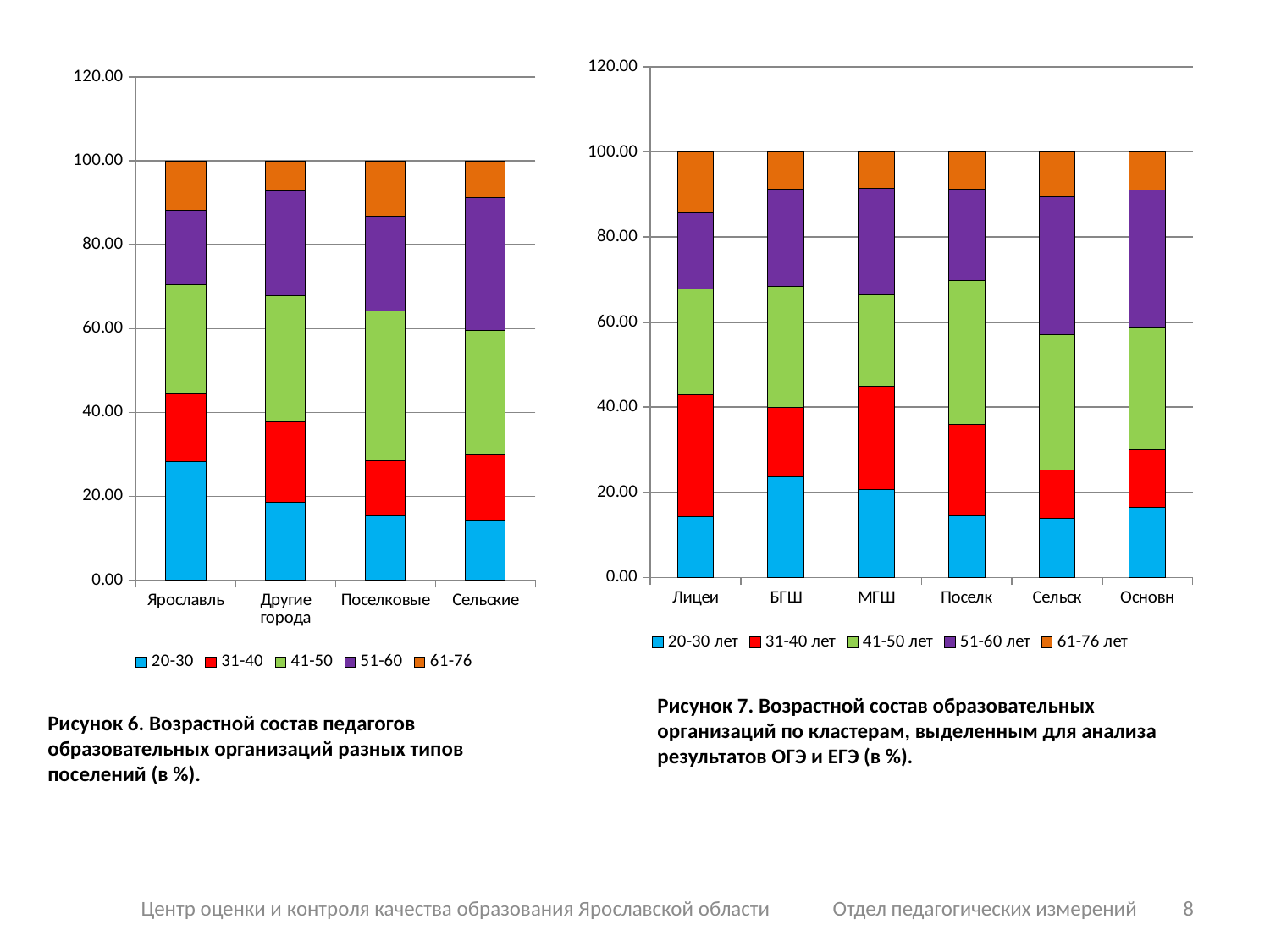
How many series does the legend of the right chart (Рисунок 7) list? 5 In the right chart (Рисунок 7), is the 20-30 лет value for Лицеи greater or less than 20? less In the left chart (Рисунок 6), which is larger: the 20-30 segment for Ярославль or for Другие города? Ярославль What is the last series listed in the legend of the left chart (Рисунок 6)? 61-76 In the left chart (Рисунок 6), is the 20-30 value for Ярославль greater or less than 20? greater In the right chart (Рисунок 7), which is larger: the 31-40 лет segment for МГШ or for Сельск? МГШ In the left chart (Рисунок 6), what is the total height of the stacked bar for Ярославль? 100.00 How many categories are shown on the x axis of the left chart (Рисунок 6)? 4 How many categories are shown on the x axis of the right chart (Рисунок 7)? 6 In the left chart (Рисунок 6), which category has the largest 20-30 segment? Ярославль What kind of chart is the left chart (Рисунок 6)? Stacked bar chart In the right chart (Рисунок 7), which category has the largest 20-30 лет segment? БГШ